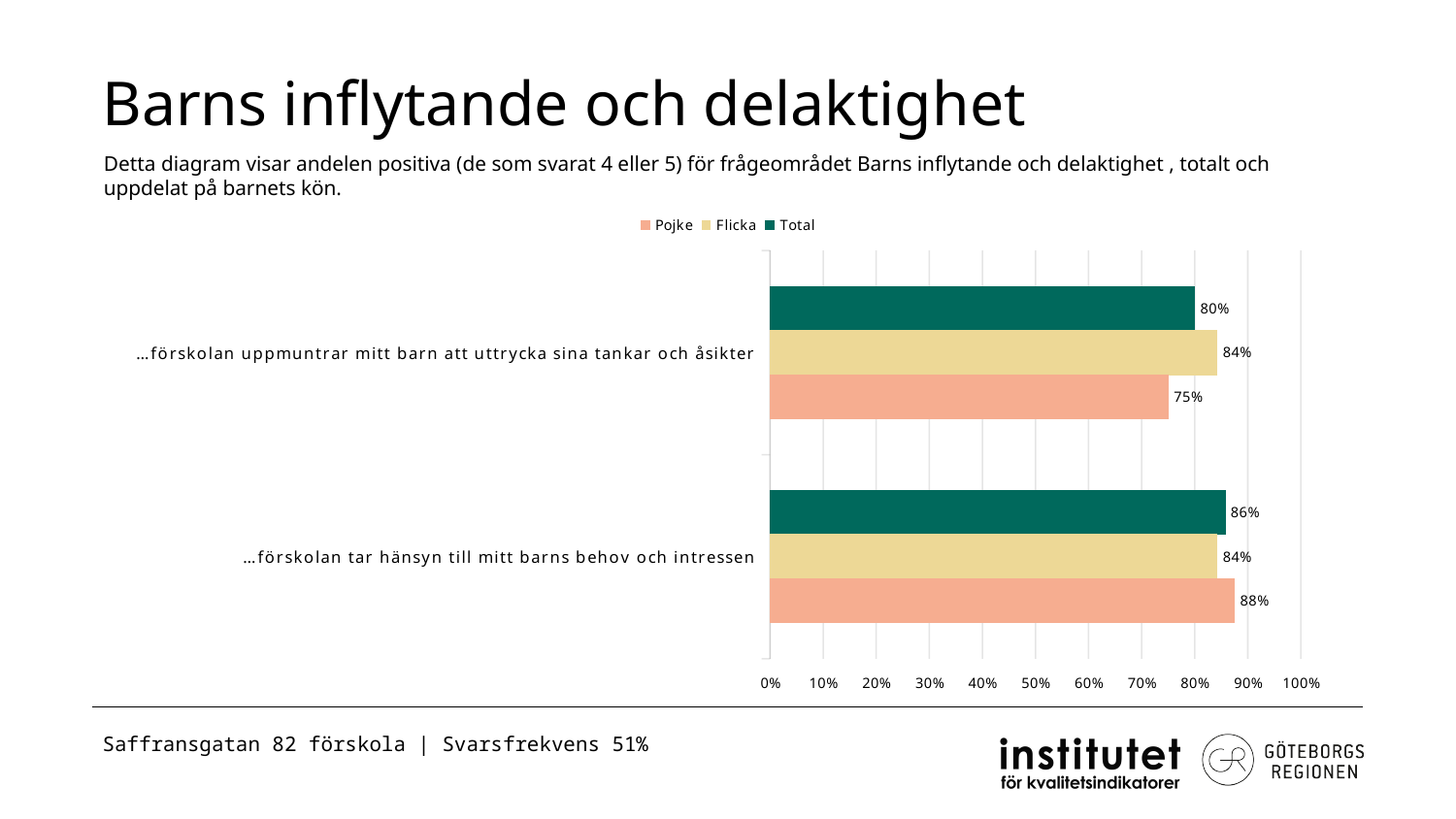
Which is larger: the Total value for "…förskolan tar hänsyn till mitt barns behov och intressen" or the Total value for "…förskolan uppmuntrar mitt barn att uttrycka sina tankar och åsikter"? …förskolan tar hänsyn till mitt barns behov och intressen What is the Flicka value for "…förskolan tar hänsyn till mitt barns behov och intressen"? 84% How many series does the legend list? 3 Which series has the highest value for "…förskolan tar hänsyn till mitt barns behov och intressen"? Pojke What kind of chart is shown on the slide? Bar chart Which series has the lowest value for "…förskolan uppmuntrar mitt barn att uttrycka sina tankar och åsikter"? Pojke What is the Pojke value for "…förskolan tar hänsyn till mitt barns behov och intressen"? 88% What is the difference between the Flicka and Pojke values for "…förskolan uppmuntrar mitt barn att uttrycka sina tankar och åsikter"? 9% What is the Pojke value for "…förskolan uppmuntrar mitt barn att uttrycka sina tankar och åsikter"? 75% How many categories are shown on the chart? 2 What is the difference between the Pojke and Total values for "…förskolan tar hänsyn till mitt barns behov och intressen"? 2% What is the Total value for "…förskolan uppmuntrar mitt barn att uttrycka sina tankar och åsikter"? 80%